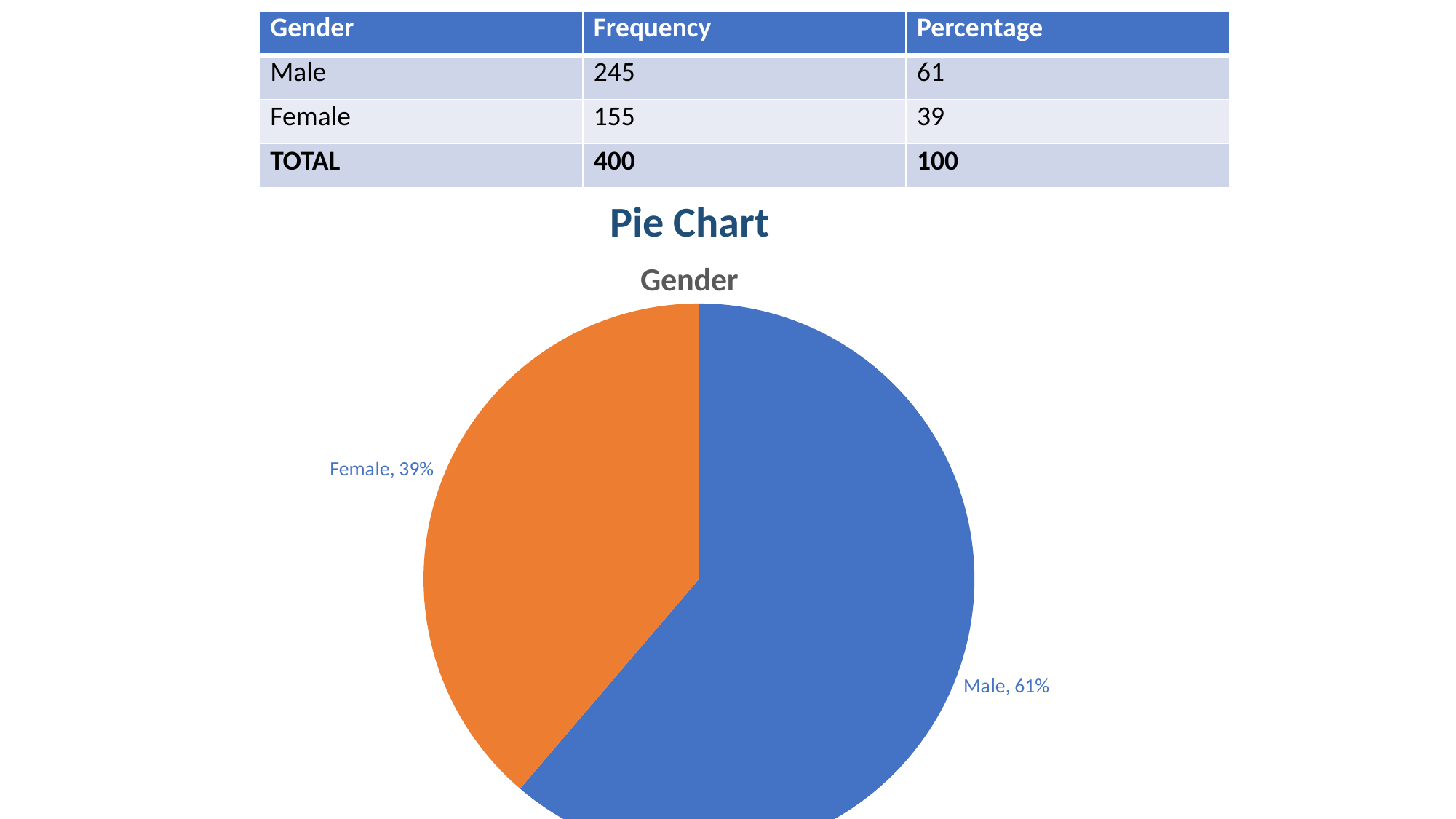
What is the title of the chart? Gender Which is larger, the Male slice or the Female slice? Male How many slices does the pie chart have? 2 What kind of chart is shown on the slide? pie chart What is the difference in percentage points between the Male and Female slices? 22 Which slice is the largest in the pie chart? Male What percentage does the Female slice show? 39% Which slice is the smallest in the pie chart? Female What share of the pie does the Female slice represent? 39% What colour is the Male slice? blue What percentage does the Male slice show? 61%